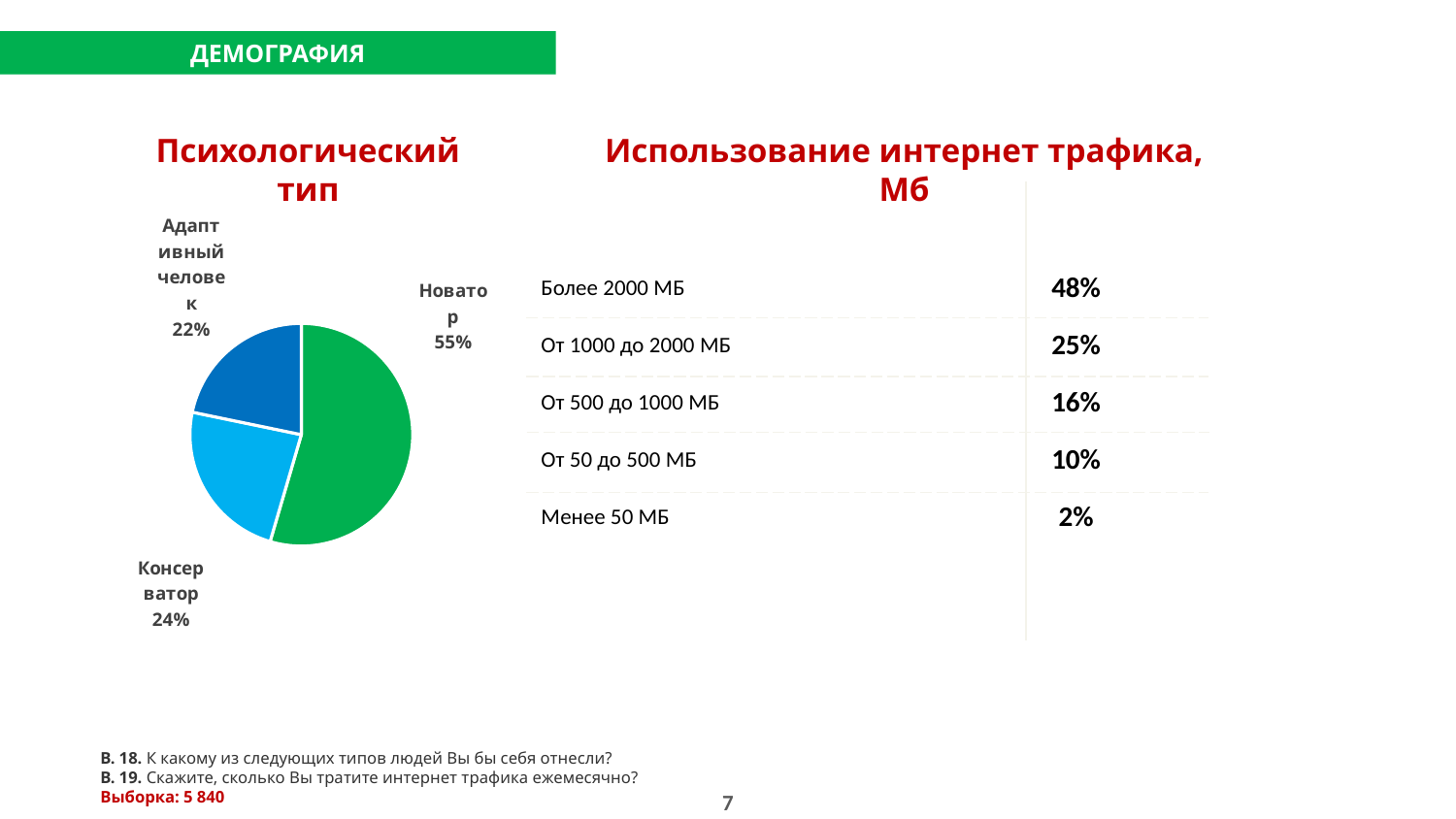
In the 'Психологический тип' pie chart, what is the difference between the Новатор and Консерватор shares? 31% In the 'Психологический тип' pie chart, which category has the smallest slice? Адаптивный человек In the 'Психологический тип' pie chart, what share is labelled for Адаптивный человек? 22% In the 'Психологический тип' pie chart, what share is labelled for Новатор? 55% In the 'Психологический тип' pie chart, how many slices are there? 3 In the 'Психологический тип' pie chart, what share is labelled for Консерватор? 24% In 'Использование интернет трафика, Мб', which category has the lowest value? Менее 50 МБ In the 'Психологический тип' pie chart, which is larger: Консерватор or Адаптивный человек? Консерватор In 'Использование интернет трафика, Мб', what is the value for 'Более 2000 МБ'? 48% In the 'Психологический тип' pie chart, what colour is the Новатор slice? green In the 'Психологический тип' pie chart, which category has the largest slice? Новатор What kind of chart is the 'Психологический тип' chart? pie chart